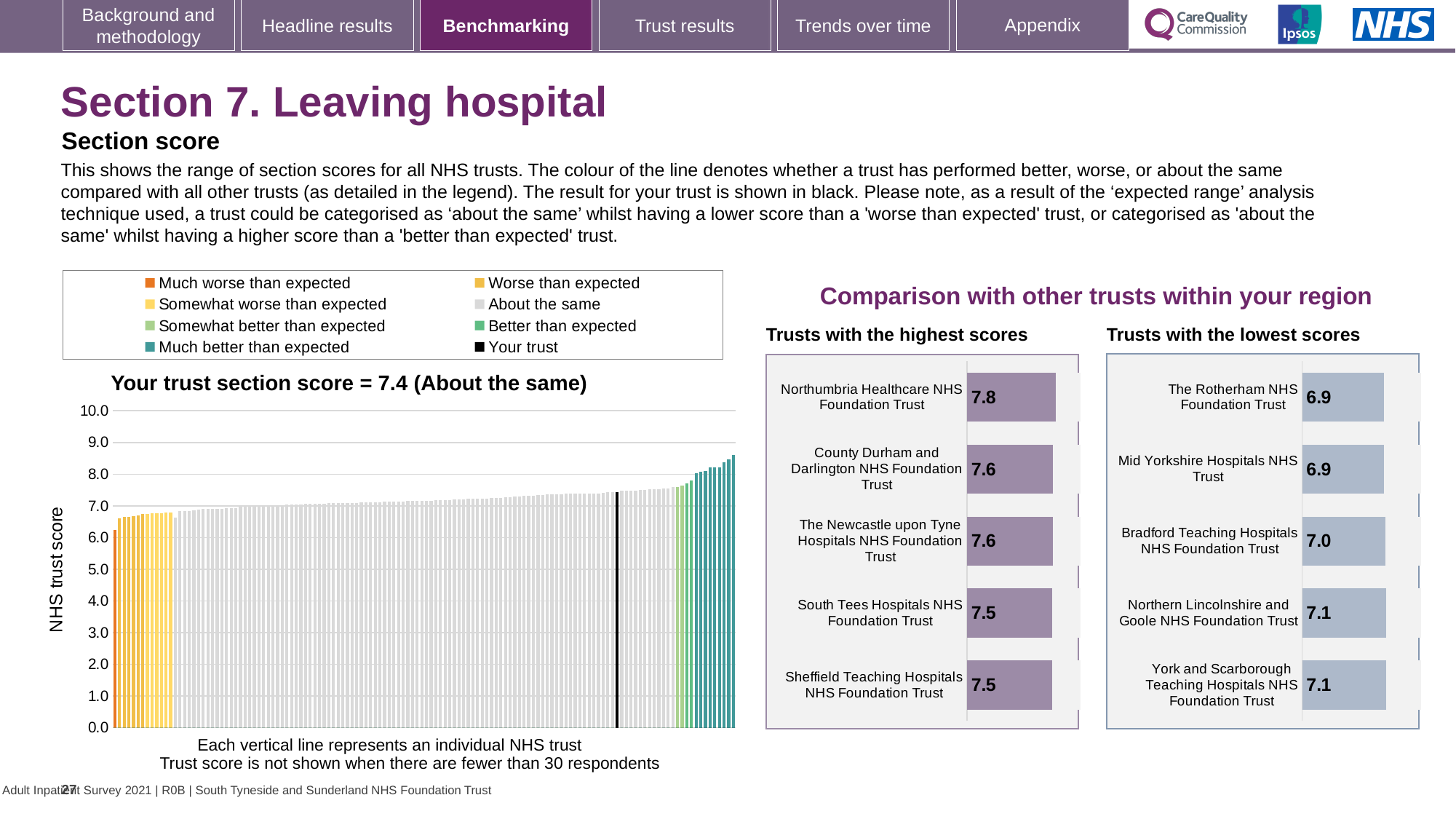
On the 'Trusts with the lowest scores' chart, what is the score for Bradford Teaching Hospitals NHS Foundation Trust? 7.0 How many entries does the legend above the 'Your trust section score' chart list? 8 On the 'Your trust section score' chart, is the value for your trust (the black bar) greater or less than 7.0? greater On the 'Trusts with the highest scores' chart, which trust has the highest score? Northumbria Healthcare NHS Foundation Trust How many trusts are shown on the 'Trusts with the lowest scores' chart? 5 On the 'Trusts with the lowest scores' chart, what is the difference between the scores of York and Scarborough Teaching Hospitals NHS Foundation Trust and The Rotherham NHS Foundation Trust? 0.2 What kind of chart is the 'Your trust section score' chart? bar chart On the 'Trusts with the highest scores' chart, what is the score for Northumbria Healthcare NHS Foundation Trust? 7.8 On the 'Trusts with the highest scores' chart, what is the difference between the scores of Northumbria Healthcare NHS Foundation Trust and South Tees Hospitals NHS Foundation Trust? 0.3 On the 'Your trust section score' chart, what is the section score for your trust? 7.4 On the 'Your trust section score' chart, do the trust scores rise or fall from left to right? rise What is the y-axis label on the 'Your trust section score' chart? NHS trust score